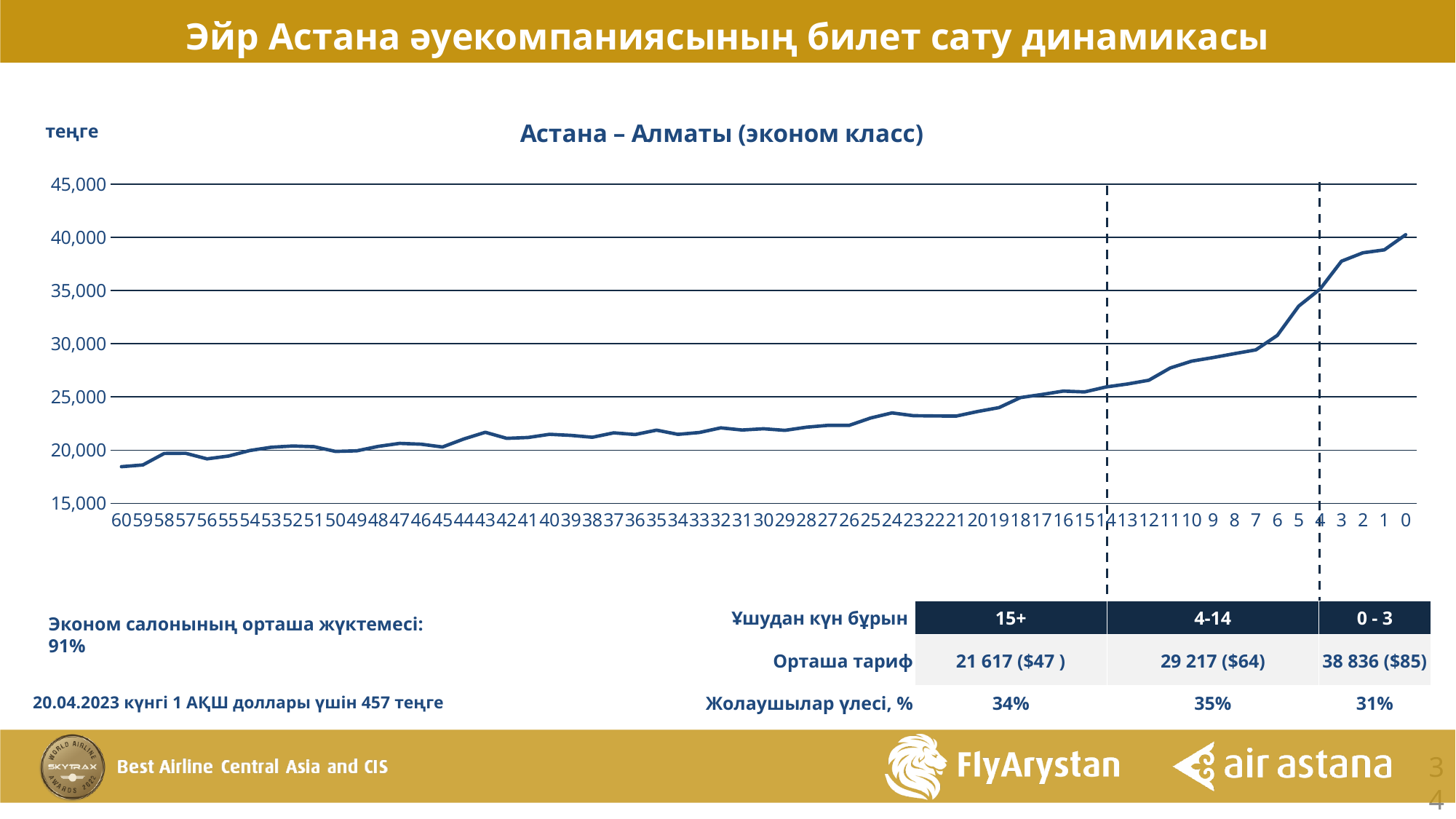
What unit is shown for the vertical axis of the chart? теңге Is the value at x = 60 greater or less than 20,000? less Which is larger, the value at x = 0 or the value at x = 60? x = 0 What is the title of the chart? Астана – Алматы (эконом класс) What kind of chart is shown on the slide? line chart How many points are plotted on the line (x axis from 60 to 0)? 61 Moving from left to right along the x axis (from 60 to 0), do the values rise or fall overall? rise Is the value at x = 30 greater or less than 25,000? less Is the value at x = 0 greater or less than 35,000? greater Which x-axis category has the highest value on the line? 0